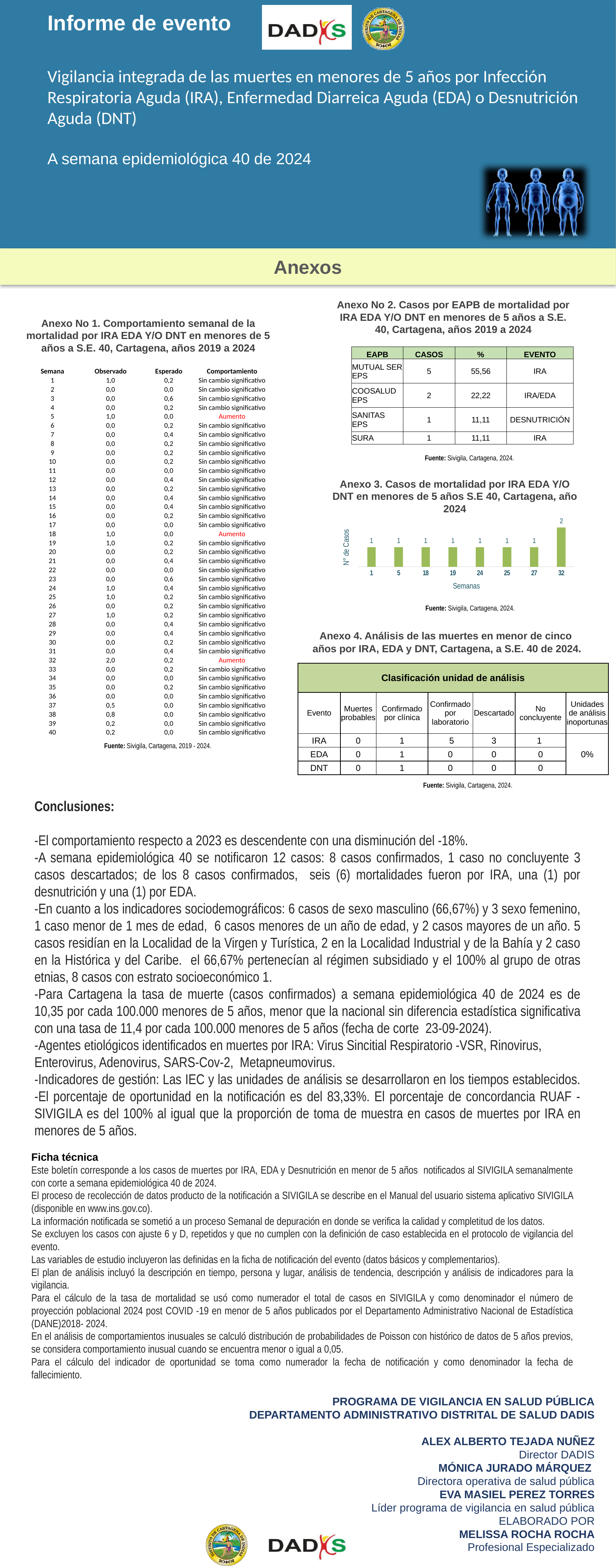
In the Anexo 3 chart, what is the number of cases for week 1? 1 In the Anexo 3 chart, what is the number of cases for week 32? 2 In the Anexo 3 chart, how many weeks (bars) are plotted? 8 In the Anexo 3 chart, what is the number of cases for week 24? 1 In the Anexo 3 chart, what is the number of cases for week 18? 1 In the Anexo 3 chart, what is the difference in cases between week 32 and week 27? 1 In the Anexo 3 chart, what is the total number of cases across all plotted weeks? 9 In the Anexo 3 chart, which week has the highest number of cases? 32 In the Anexo 3 chart, what is the label of the x axis? Semanas In the Anexo 3 chart, which has more cases, week 32 or week 25? week 32 In the Anexo 3 chart, what kind of chart is shown? bar chart In the Anexo 3 chart, what is the label of the y axis? N° de Casos